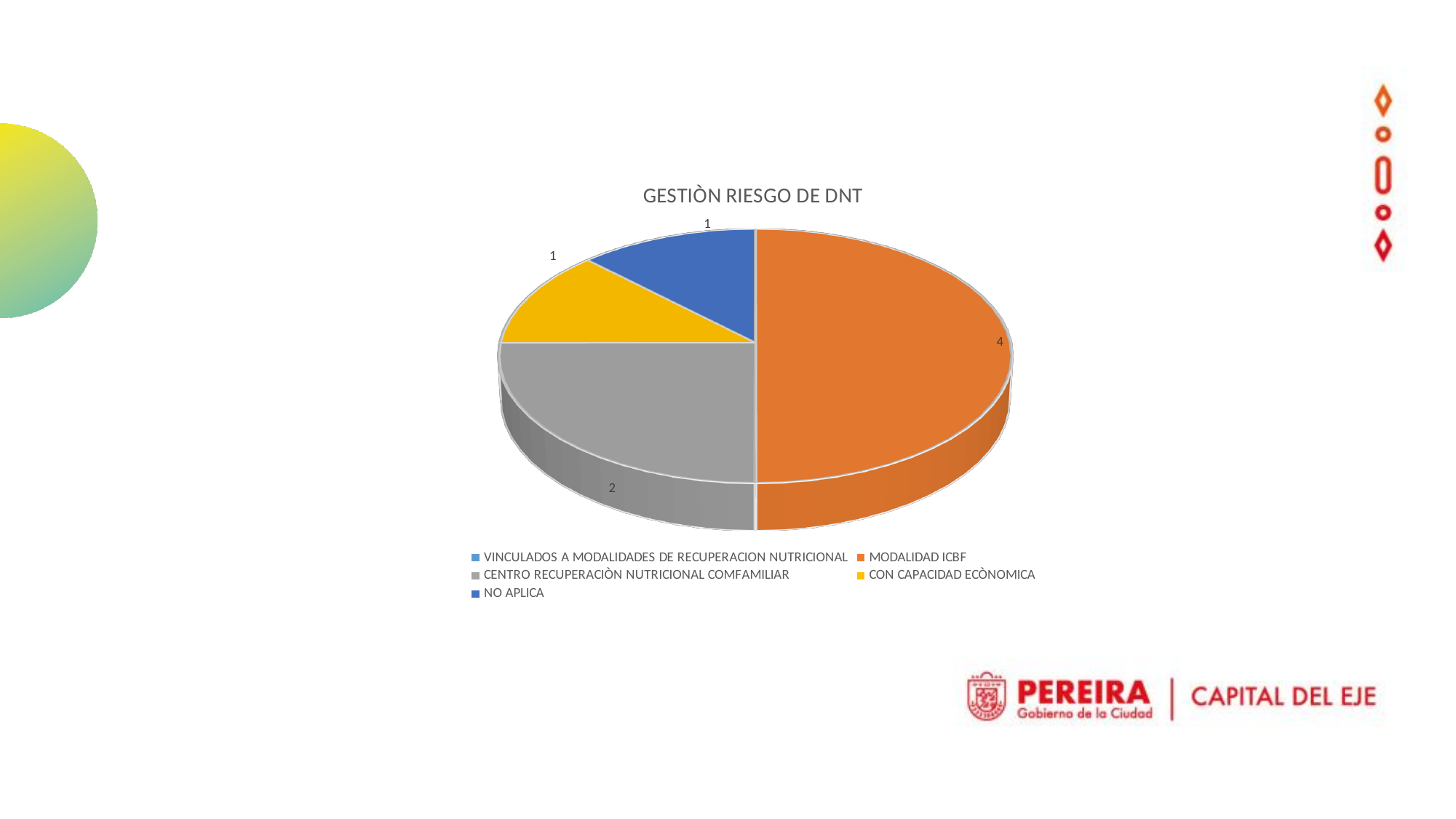
Which category has the largest slice of the pie? MODALIDAD ICBF How many slices are visible in the pie? 4 What is the difference between the values for MODALIDAD ICBF and CENTRO RECUPERACIÒN NUTRICIONAL COMFAMILIAR? 2 What colour is the slice for MODALIDAD ICBF? orange What is the value for MODALIDAD ICBF? 4 What is the value for CON CAPACIDAD ECÒNOMICA? 1 What share of the pie does MODALIDAD ICBF represent? 50% What is the value for CENTRO RECUPERACIÒN NUTRICIONAL COMFAMILIAR? 2 What is the title of the chart? GESTIÒN RIESGO DE DNT What kind of chart is shown on the slide? pie chart How many entries does the legend list? 5 Which is larger, the value for MODALIDAD ICBF or the value for CON CAPACIDAD ECÒNOMICA? MODALIDAD ICBF